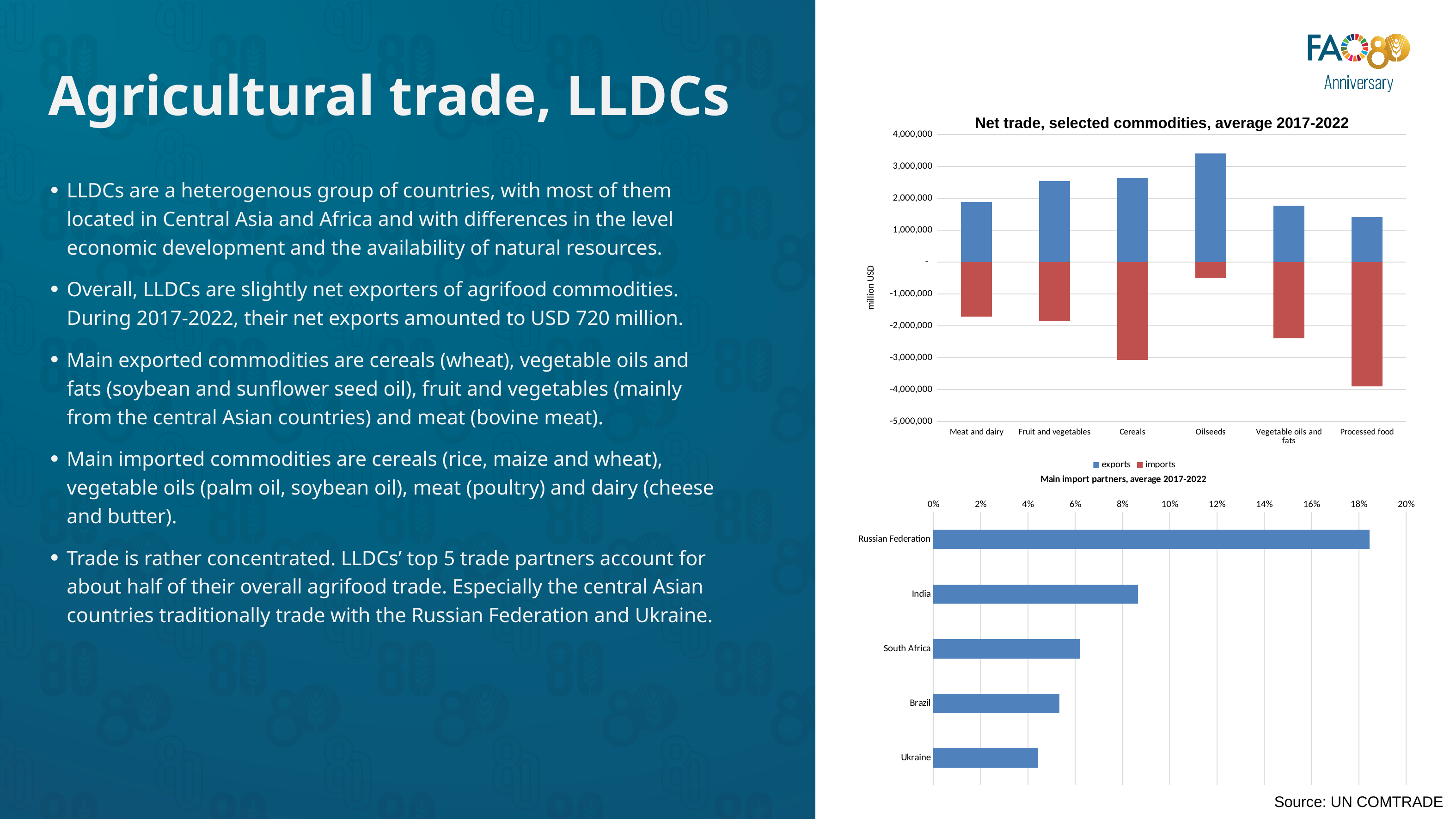
In the 'Net trade, selected commodities, average 2017-2022' chart, which commodity has the lowest exports value? Processed food In the 'Net trade, selected commodities, average 2017-2022' chart, is the imports value for Processed food greater or less than -3,000,000? less In the 'Net trade, selected commodities, average 2017-2022' chart, is the imports value for Oilseeds greater or less than -1,000,000? greater In the 'Net trade, selected commodities, average 2017-2022' chart, how many commodity categories are shown on the x axis? 6 In the 'Main import partners, average 2017-2022' chart, is the value for India greater or less than 8%? greater In the 'Main import partners, average 2017-2022' chart, which partner has the lowest share? Ukraine What kind of chart is 'Main import partners, average 2017-2022'? bar chart In the 'Net trade, selected commodities, average 2017-2022' chart, which commodity has the highest exports value? Oilseeds In the 'Net trade, selected commodities, average 2017-2022' chart, which commodity has the largest (most negative) imports bar? Processed food In the 'Main import partners, average 2017-2022' chart, which partner has the highest share? Russian Federation In the 'Net trade, selected commodities, average 2017-2022' chart, how many series does the legend list? 2